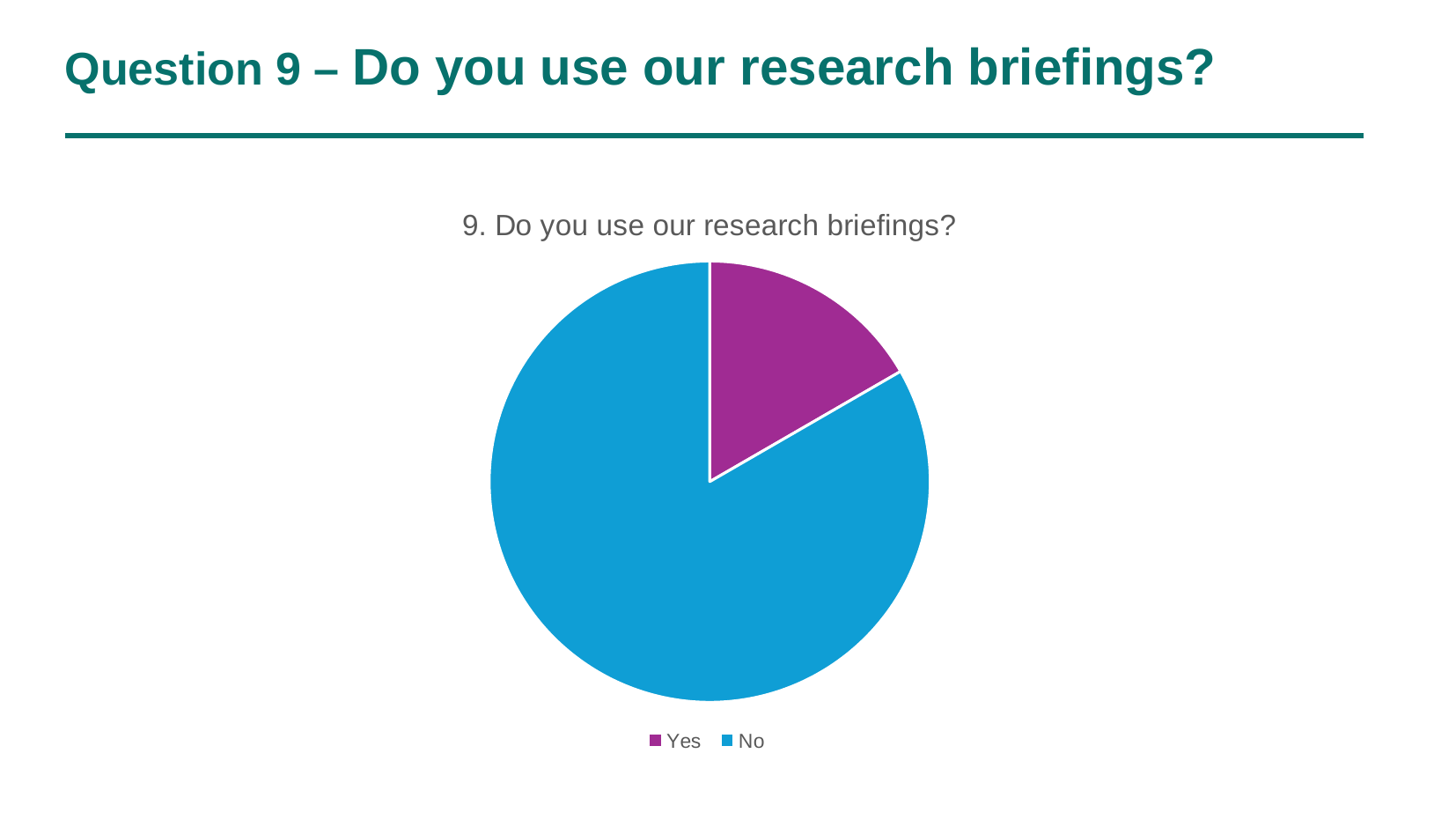
What kind of chart is shown on the slide? Pie chart Which category has the largest slice of the pie? No How many categories does the pie chart show? 2 What colour is the slice for Yes? Purple Which category has the smallest slice of the pie? Yes How many entries does the legend list? 2 What is the title of the chart? 9. Do you use our research briefings? Which slice is larger, Yes or No? No